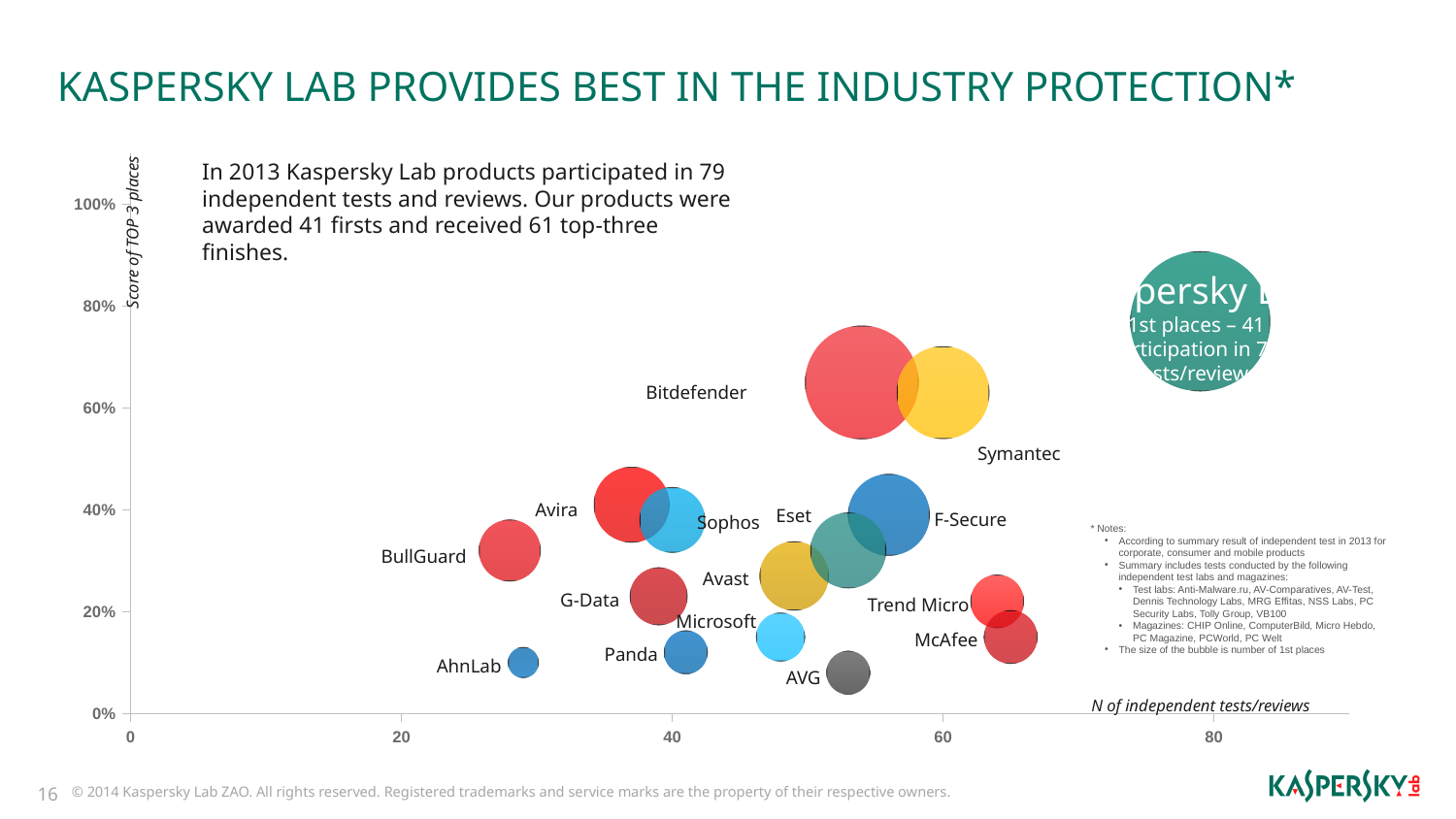
Is the score of TOP 3 places for McAfee greater or less than 40%? less Which vendor participated in more independent tests/reviews, Kaspersky Lab or Avira? Kaspersky Lab Which vendor has the highest score of TOP 3 places? Kaspersky Lab Which has a higher score of TOP 3 places, Bitdefender or BullGuard? Bitdefender Is the score of TOP 3 places for AhnLab greater or less than 20%? less Is the number of independent tests/reviews for BullGuard greater or less than 40? less What does the x axis of the chart represent? N of independent tests/reviews How many vendor bubbles are plotted on the chart? 16 What kind of chart is shown on the slide? Bubble chart How many 1st places does the Kaspersky Lab bubble state? 41